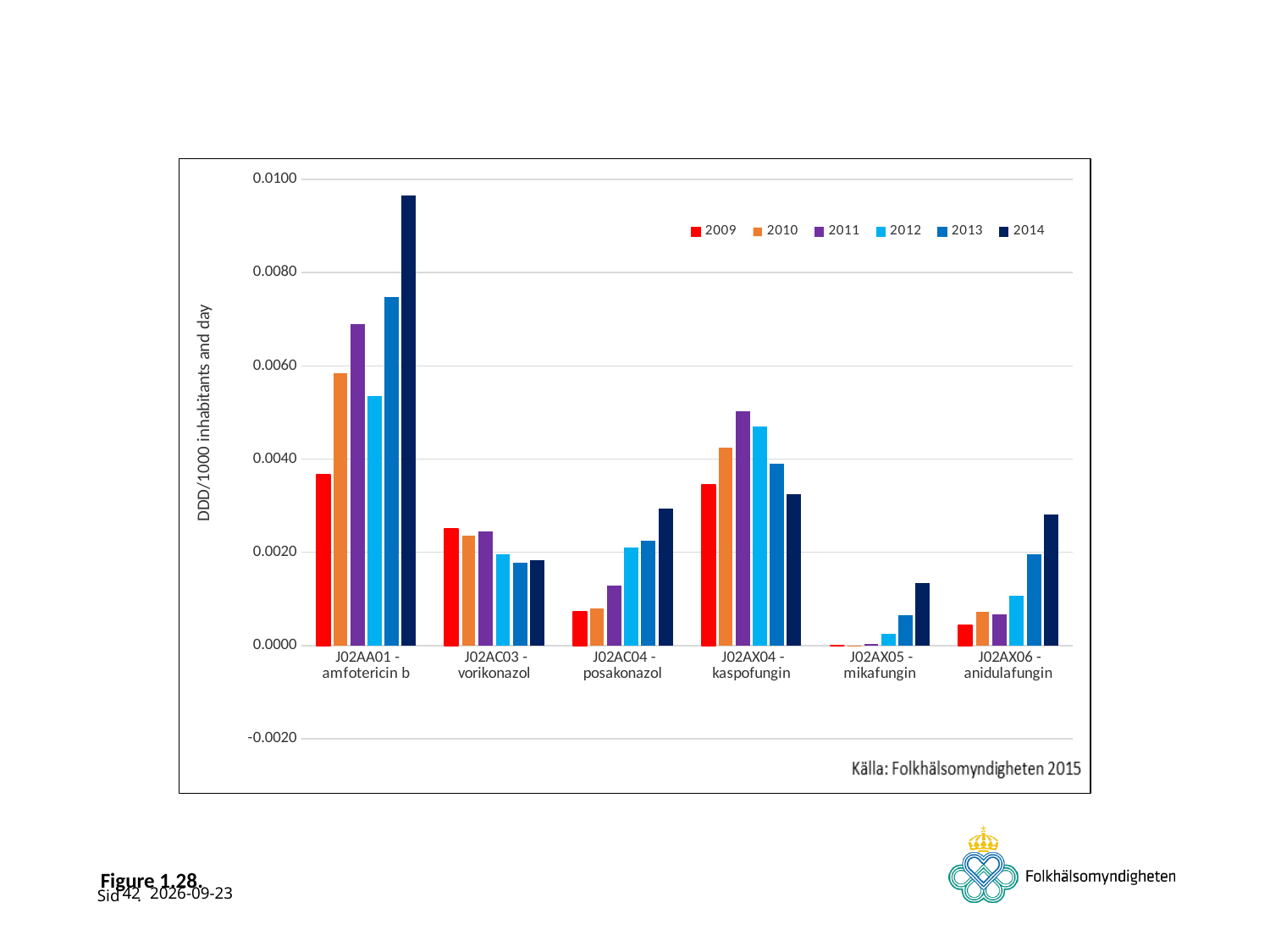
Is the 2014 value for J02AX06 - anidulafungin greater or less than 0.0020? greater Which is larger in 2014: J02AC04 - posakonazol or J02AC03 - vorikonazol? J02AC04 - posakonazol Is the 2014 value for J02AA01 - amfotericin b greater or less than 0.0080? greater Which category has the highest value for 2014? J02AA01 - amfotericin b What is the label on the y axis? DDD/1000 inhabitants and day How many series (years) does the legend list? 6 Which is larger in 2011: J02AA01 - amfotericin b or J02AX04 - kaspofungin? J02AA01 - amfotericin b Is the 2009 value for J02AX04 - kaspofungin greater or less than 0.0040? less How many drug categories are shown on the x axis? 6 What kind of chart is shown on the slide? bar chart Do the values for J02AX05 - mikafungin rise or fall from 2009 to 2014? rise Which category has the lowest value for 2014? J02AX05 - mikafungin